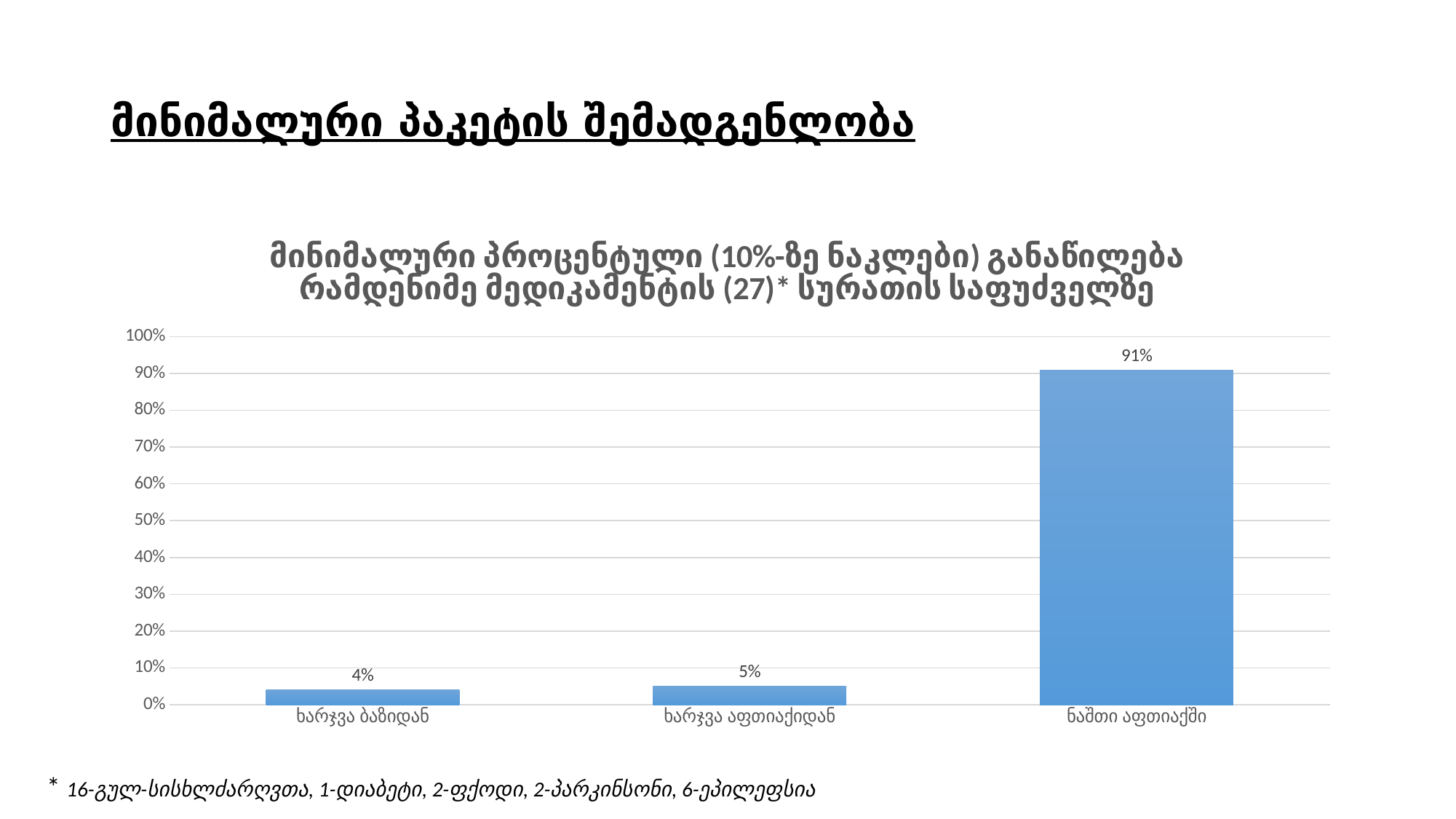
Which is larger, the value for ხარჯვა ბაზიდან or the value for ნაშთი აფთიაქში? ნაშთი აფთიაქში What is the value for ხარჯვა ბაზიდან? 4% Which category has the lowest value? ხარჯვა ბაზიდან Is the value for ნაშთი აფთიაქში greater or less than 50%? greater What is the difference between the values for ხარჯვა აფთიაქიდან and ხარჯვა ბაზიდან? 1% How many categories are shown on the x axis? 3 What is the difference between the values for ნაშთი აფთიაქში and ხარჯვა აფთიაქიდან? 86% Which category has the highest value? ნაშთი აფთიაქში What is the value for ხარჯვა აფთიაქიდან? 5% What is the highest value shown on the y axis? 100% What kind of chart is shown on the slide? bar chart What is the value for ნაშთი აფთიაქში? 91%